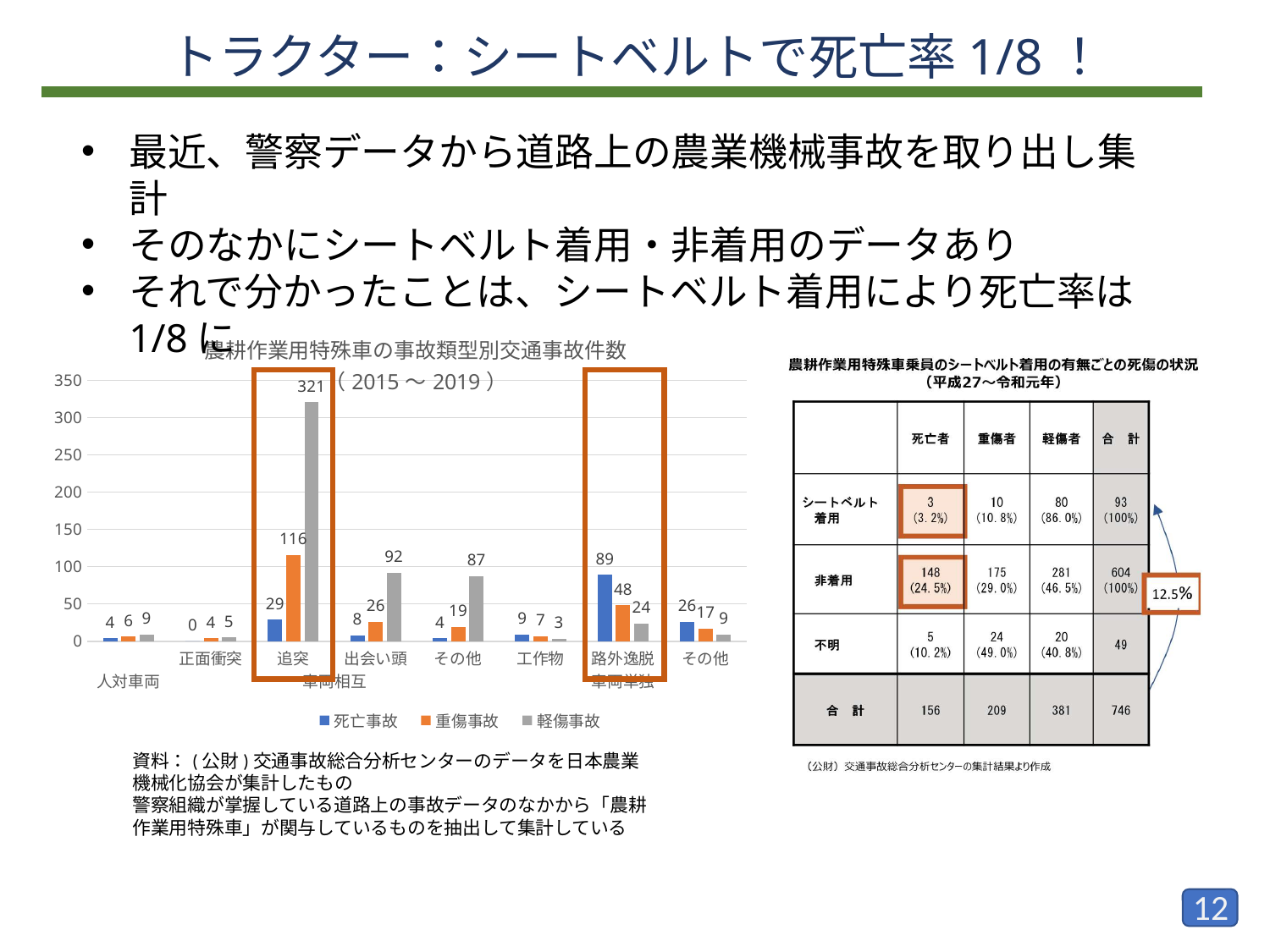
What is the title of the bar chart? 農耕作業用特殊車の事故類型別交通事故件数（2015～2019） In the bar chart, which category has the highest 軽傷事故 value? 追突 How many series does the legend of the bar chart list? 3 What kind of chart is shown on the left of the slide? bar chart In the bar chart, what is the value of 重傷事故 for 出会い頭? 26 In the bar chart, which category has the highest 死亡事故 value? 路外逸脱 In the bar chart, what is the value of 死亡事故 for 路外逸脱? 89 In the bar chart, what is the total of the three series for 追突? 466 In the bar chart, which is larger: the 死亡事故 value for 工作物 or the 死亡事故 value for 出会い頭? 工作物 In the bar chart, what is the difference between the 重傷事故 value for 追突 and the 重傷事故 value for 路外逸脱? 68 In the bar chart, what is the value of 軽傷事故 for 追突? 321 In the bar chart, what is the value of 死亡事故 for 正面衝突? 0